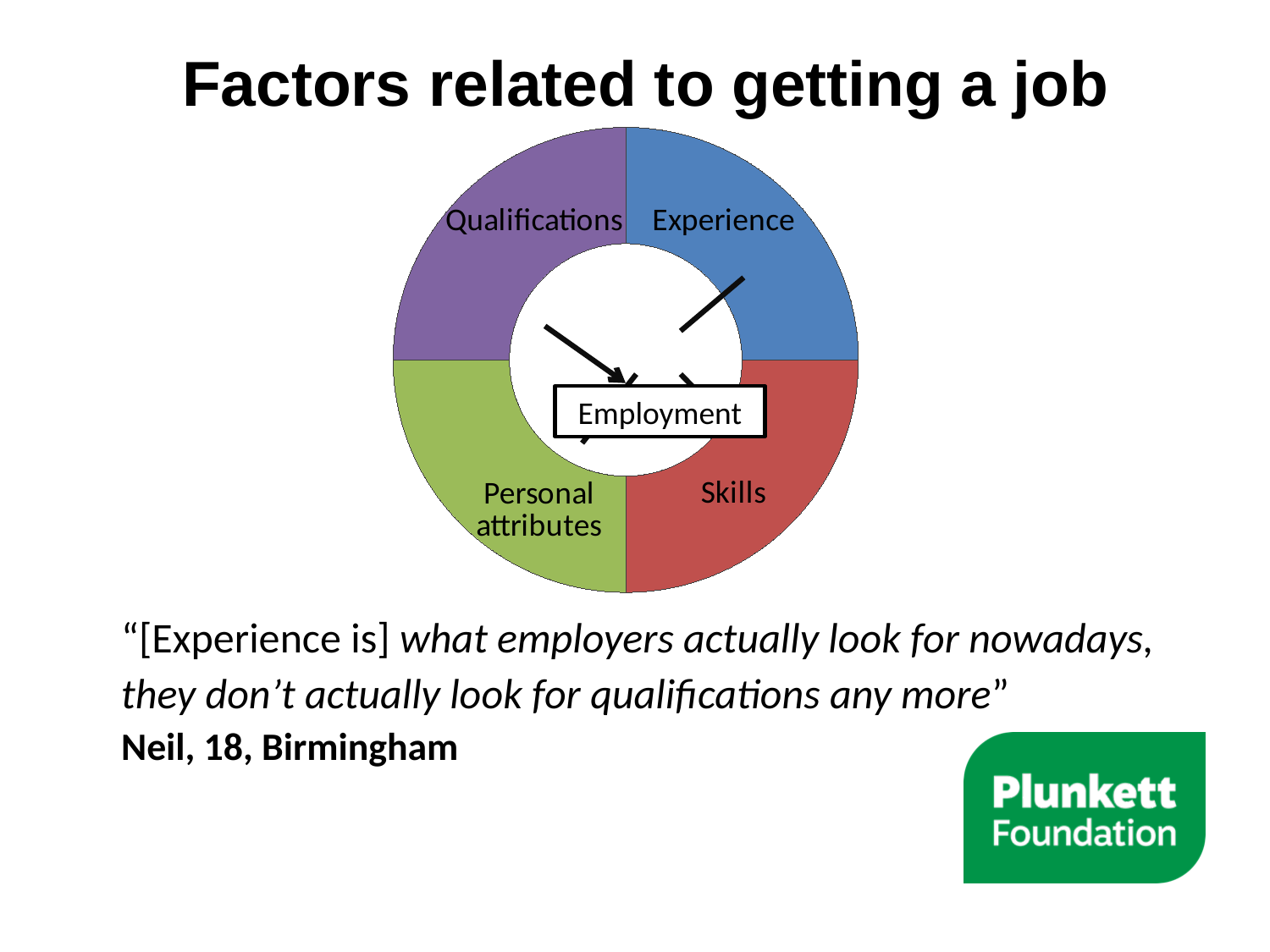
What word appears in the box at the centre of the doughnut chart? Employment What colour is the Skills segment of the chart? Red Do the four segments of the doughnut chart appear equal in size? Yes How many segments does the doughnut chart have? 4 What kind of chart is shown on the slide? Doughnut chart Which four factors are labelled on the segments of the chart? Experience, Skills, Personal attributes, Qualifications